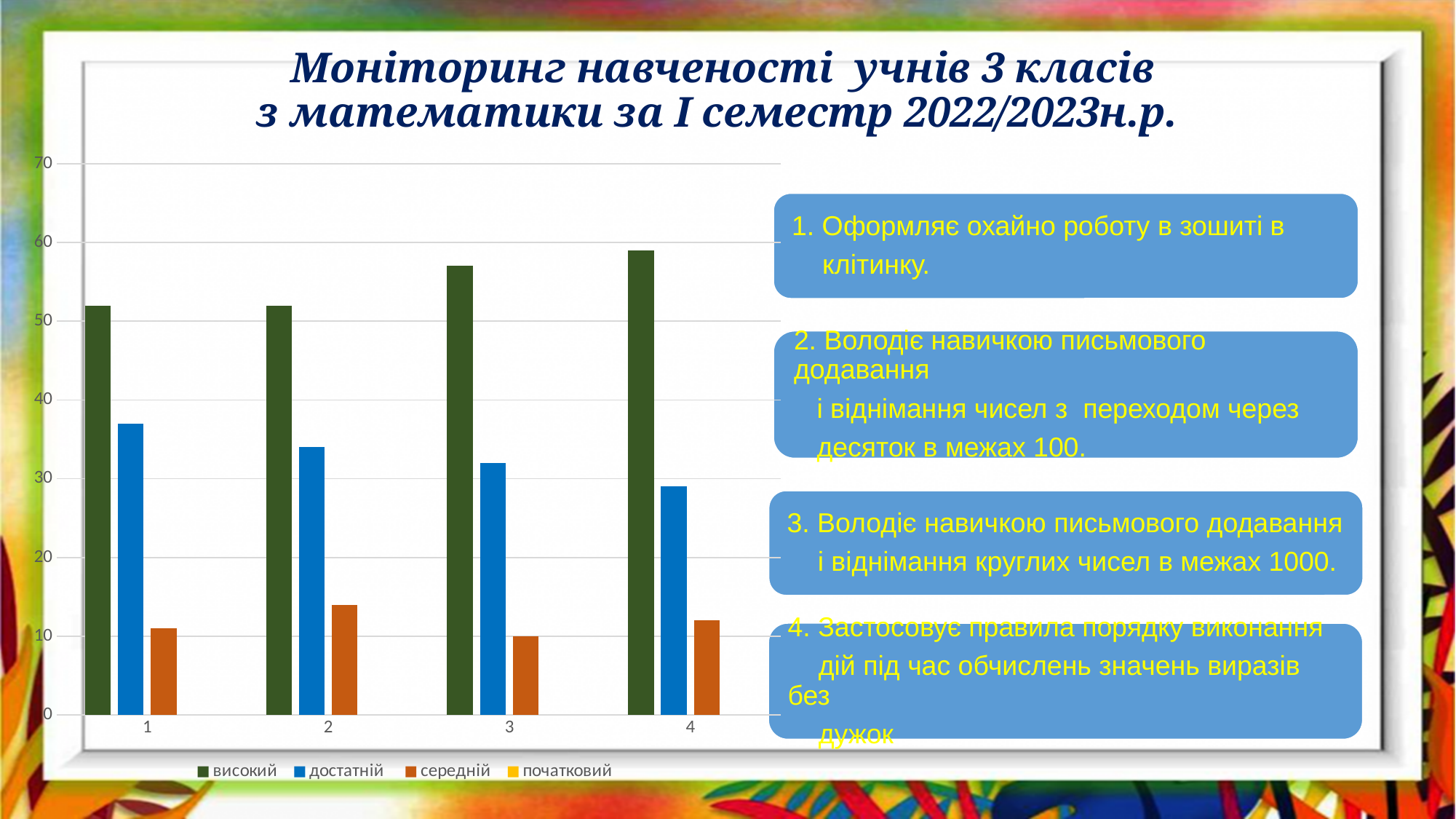
For which category is the достатній series highest? 1 Do the values of the достатній series rise or fall from category 1 to category 4? fall Is the value of the достатній series for category 4 greater or less than 20? greater In category 1, which series has the larger value, високий or достатній? високий Is the value of the високий series for category 1 greater or less than 50? greater Is the value of the середній series for category 2 greater or less than 10? greater How many categories are shown on the x axis of the chart? 4 What kind of chart is shown on the slide? bar chart How many series does the chart legend list? 4 For which category is the достатній series lowest? 4 Which series is shown in dark green in the chart legend? високий